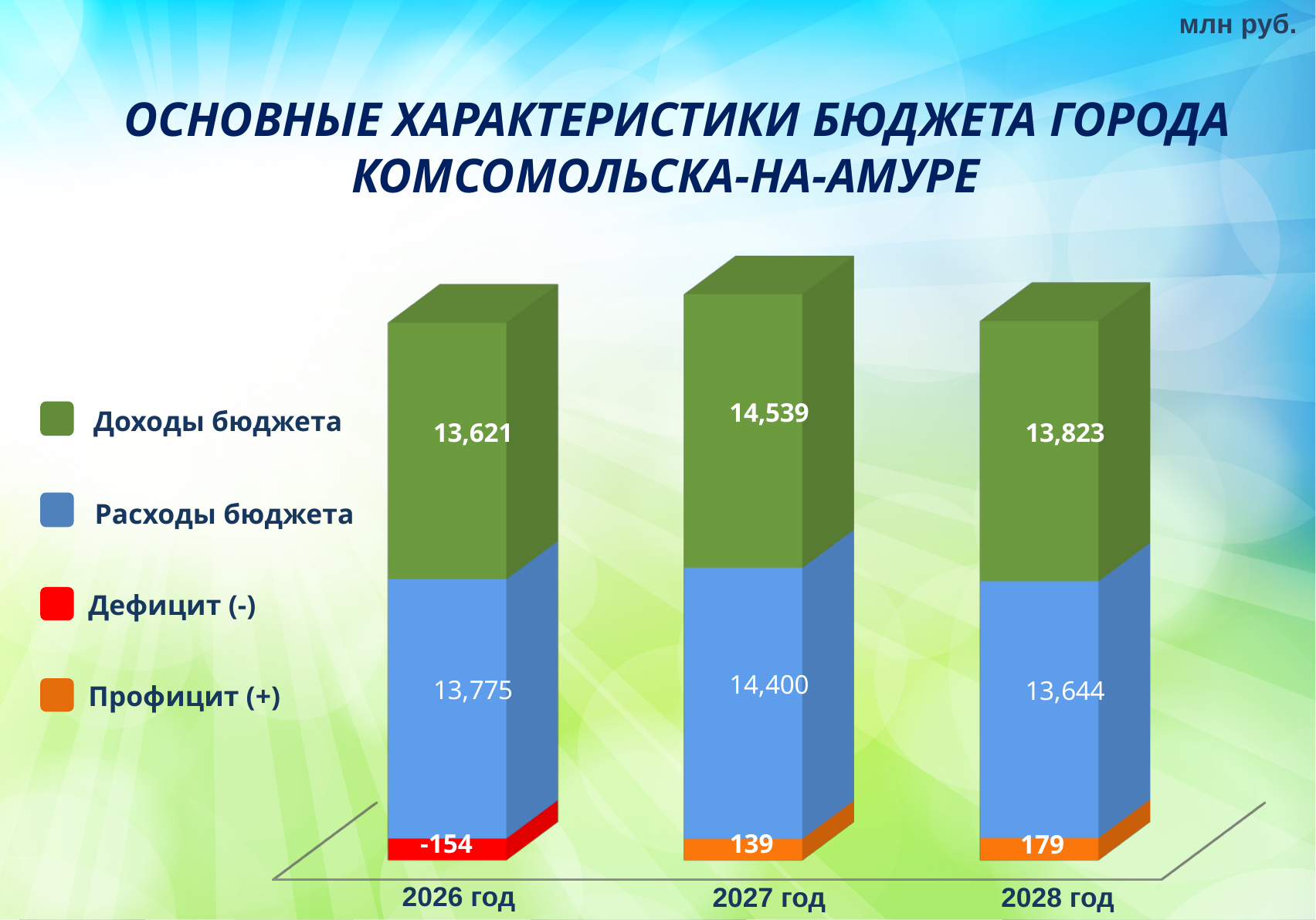
What is the difference between Доходы бюджета for 2027 год and 2028 год? 716 What is the value of Профицит (+) for 2028 год? 179 How many years are shown on the x axis? 3 What is the value of Расходы бюджета for 2027 год? 14,400 What is the value of Доходы бюджета for 2026 год? 13,621 What is the value of Дефицит (-) for 2026 год? -154 How many entries does the legend list? 4 What kind of chart is shown on the slide? Stacked bar chart Which year has the lowest value of Расходы бюджета? 2028 год Which is larger for 2028 год: Доходы бюджета or Расходы бюджета? Доходы бюджета What is the difference between Расходы бюджета and Доходы бюджета for 2026 год? 154 Which year has the highest value of Доходы бюджета? 2027 год